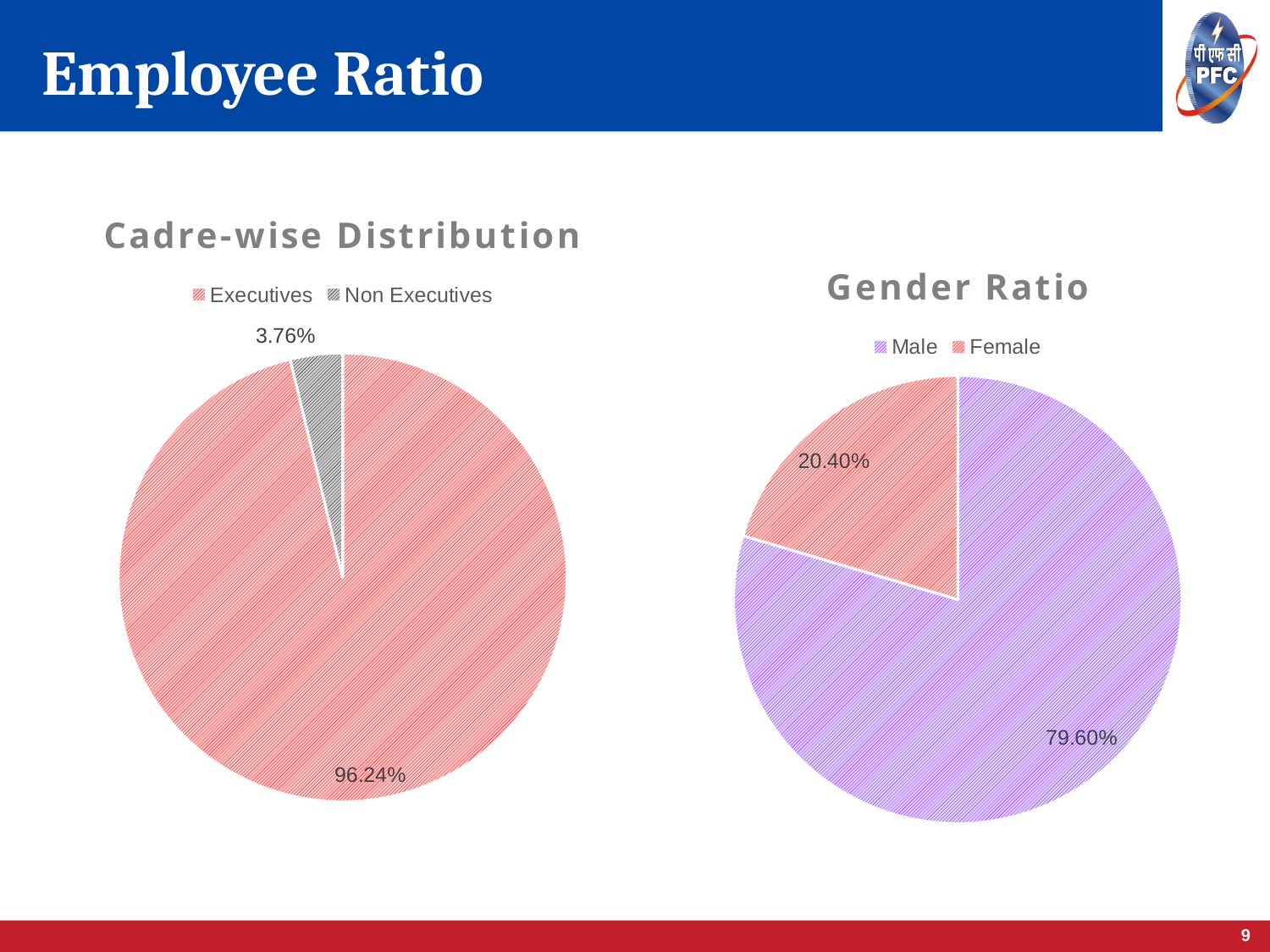
In the Gender Ratio chart, what percentage of employees are Male? 79.60% In the Cadre-wise Distribution chart, what share of employees are Non Executives? 3.76% In the Gender Ratio chart, what is the difference in percentage points between the Male and Female shares? 59.20 In the Gender Ratio chart, what percentage of employees are Female? 20.40% In the Cadre-wise Distribution chart, which category has the largest share? Executives How many categories does the legend of the Gender Ratio chart list? 2 In the Cadre-wise Distribution chart, what is the difference in percentage points between Executives and Non Executives? 92.48 How many slices does the Cadre-wise Distribution pie chart have? 2 What type of chart is the Cadre-wise Distribution chart? Pie chart In the Cadre-wise Distribution chart, what share of employees are Executives? 96.24% In the Gender Ratio chart, which category has the smallest share? Female In the Gender Ratio chart, which is larger, the Male share or the Female share? Male